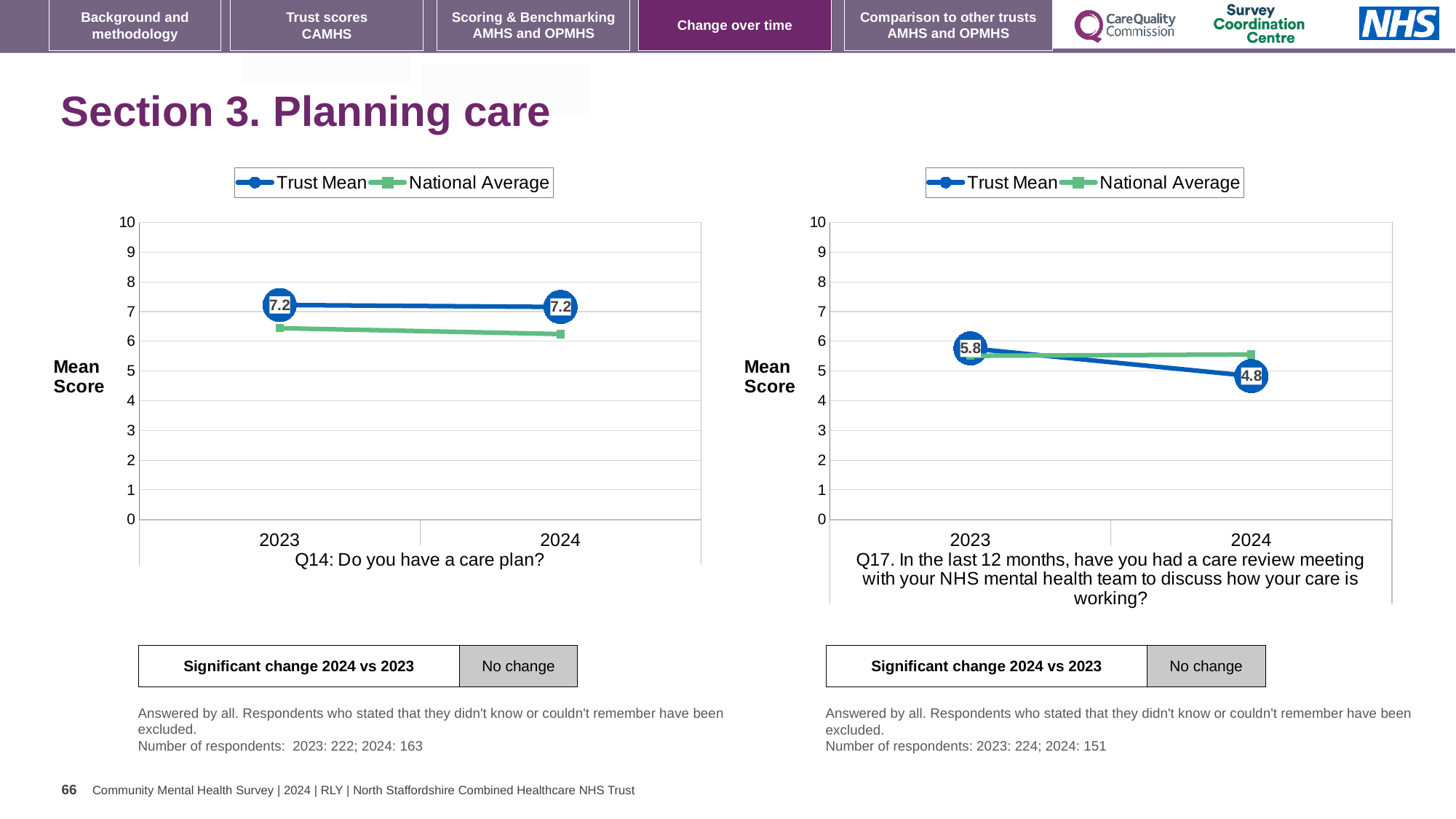
In the Q17 chart (right), what is the Trust Mean score for 2023? 5.8 In the Q17 chart (right), by how much did the Trust Mean fall from 2023 to 2024? 1.0 What kind of chart is the Q14 chart (left)? line chart In the Q17 chart (right), does the Trust Mean rise or fall from 2023 to 2024? fall In the Q17 chart (right), what is the Trust Mean score for 2024? 4.8 In the Q14 chart (left), is the National Average value for 2023 greater or less than 7? less How many series does the legend of the Q17 chart (right) list? 2 What does the 'Significant change 2024 vs 2023' box below the Q17 chart (right) say? No change In the Q14 chart (left), what is the Trust Mean score for 2023? 7.2 In the Q14 chart (left), what is the Trust Mean score for 2024? 7.2 In the Q17 chart (right), which is larger in 2024, the Trust Mean or the National Average? National Average How many years are plotted on the x axis of the Q14 chart (left)? 2